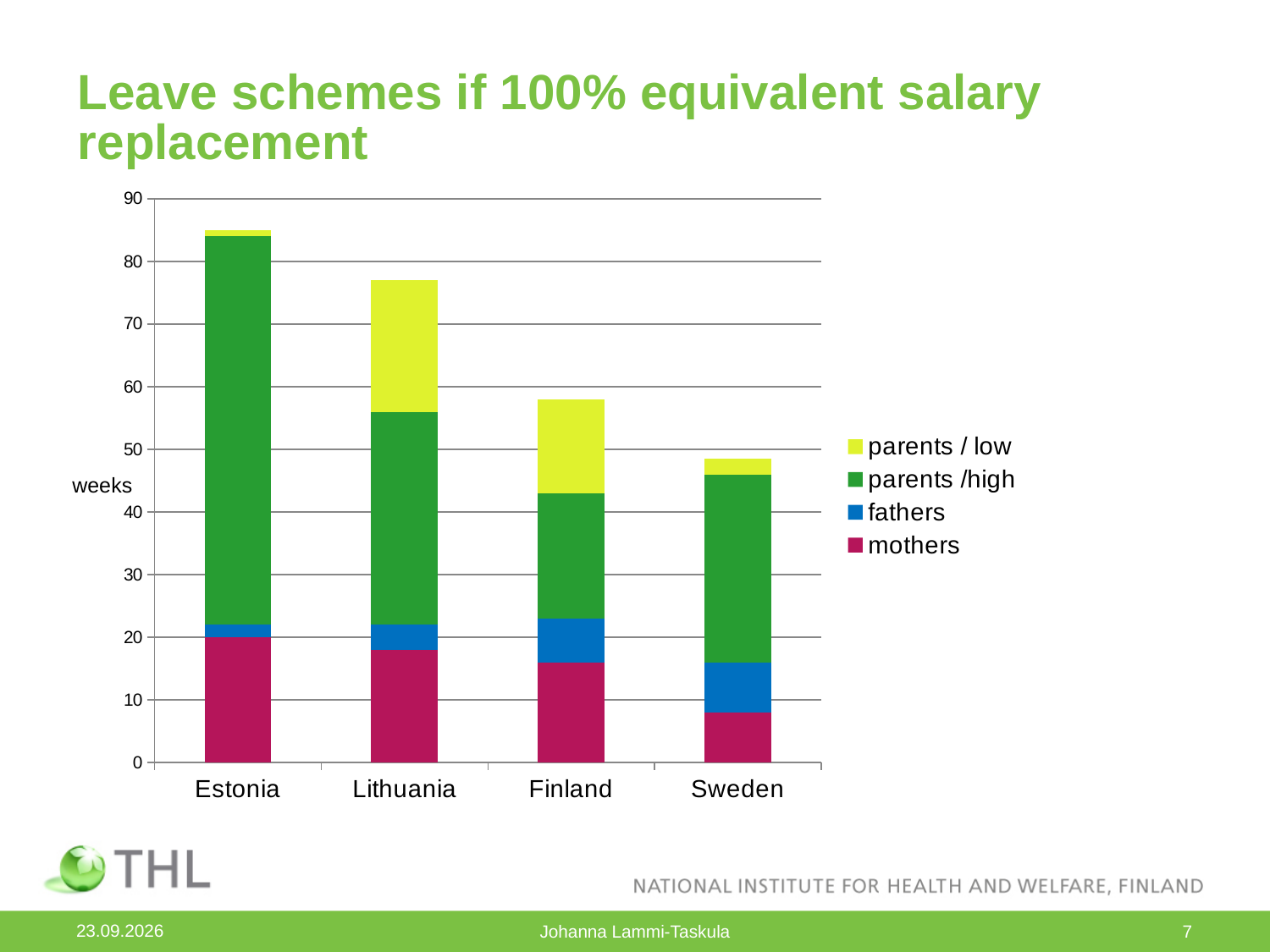
Is the 'mothers' segment for Sweden greater or less than 10 weeks? less Is the total bar height for Sweden greater or less than 50 weeks? less Is the total bar height for Finland greater or less than 50 weeks? greater Which country has the tallest stacked bar in total? Estonia How many countries are shown on the x axis of the chart? 4 How many series does the chart legend list? 4 Which country has the largest 'parents / low' segment? Lithuania Which country has the shortest stacked bar in total? Sweden Which country has a larger total bar, Lithuania or Finland? Lithuania What kind of chart is shown on the slide? stacked bar chart What is the label on the vertical axis of the chart? weeks